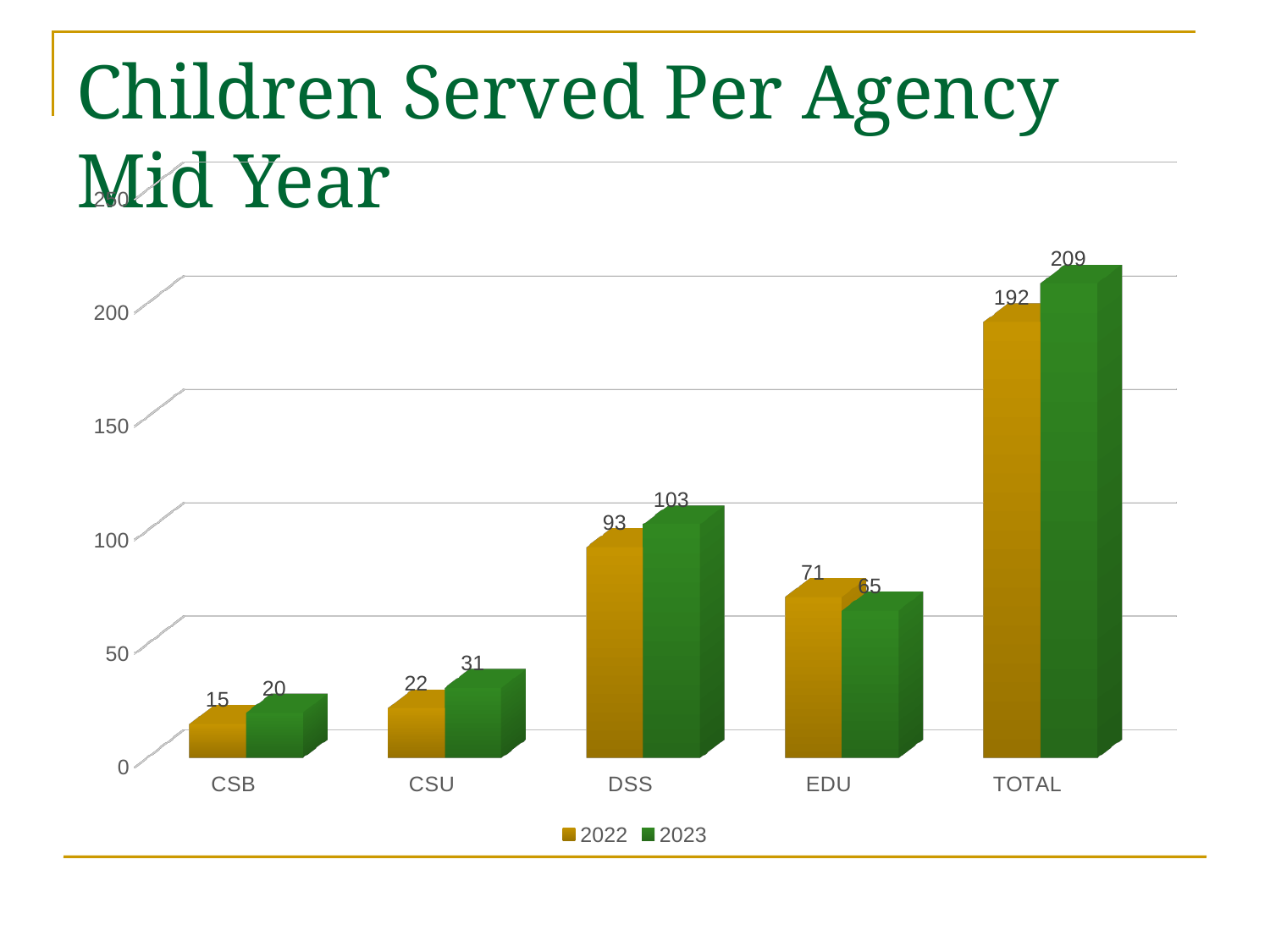
Is the 2022 value for DSS greater or less than 100? less What is the difference between the 2022 and 2023 values for EDU? 6 How many series does the legend list? 2 What is the value for EDU in 2023? 65 Excluding TOTAL, which agency has the highest value in 2022? DSS Which is larger for CSU: the 2022 value or the 2023 value? 2023 What is the value for DSS in 2023? 103 What is the difference between the 2023 and 2022 values for TOTAL? 17 Which agency has the lowest value in 2023? CSB What is the value for CSU in 2022? 22 How many categories are shown on the x axis? 5 What kind of chart is shown on the slide? bar chart